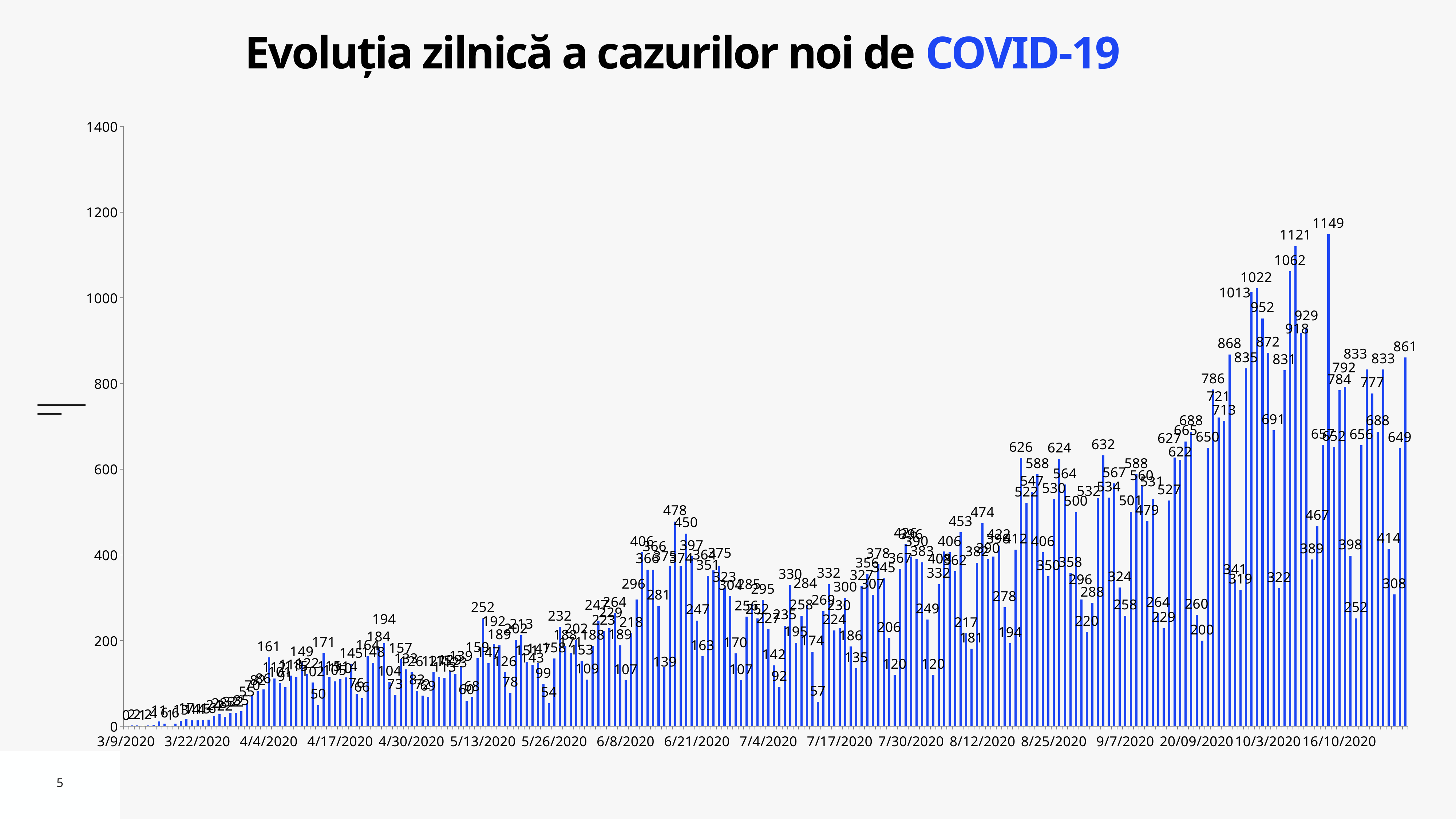
What is the title of the chart? Evoluția zilnică a cazurilor noi de COVID-19 What is the highest daily value shown on the chart? 1149 What kind of chart is shown on the slide? bar chart How many data series are plotted on the chart? 1 What is the highest tick value on the y axis? 1400 Is the highest value on the chart greater or less than 1200? less Overall, do the daily values rise or fall from March 2020 to October 2020? rise What is the first date label on the x axis? 3/9/2020 Is the highest value on the chart greater or less than 1000? greater What is the lowest value shown on the chart? 0 Is the value for the first bar (3/9/2020) greater or less than 200? less